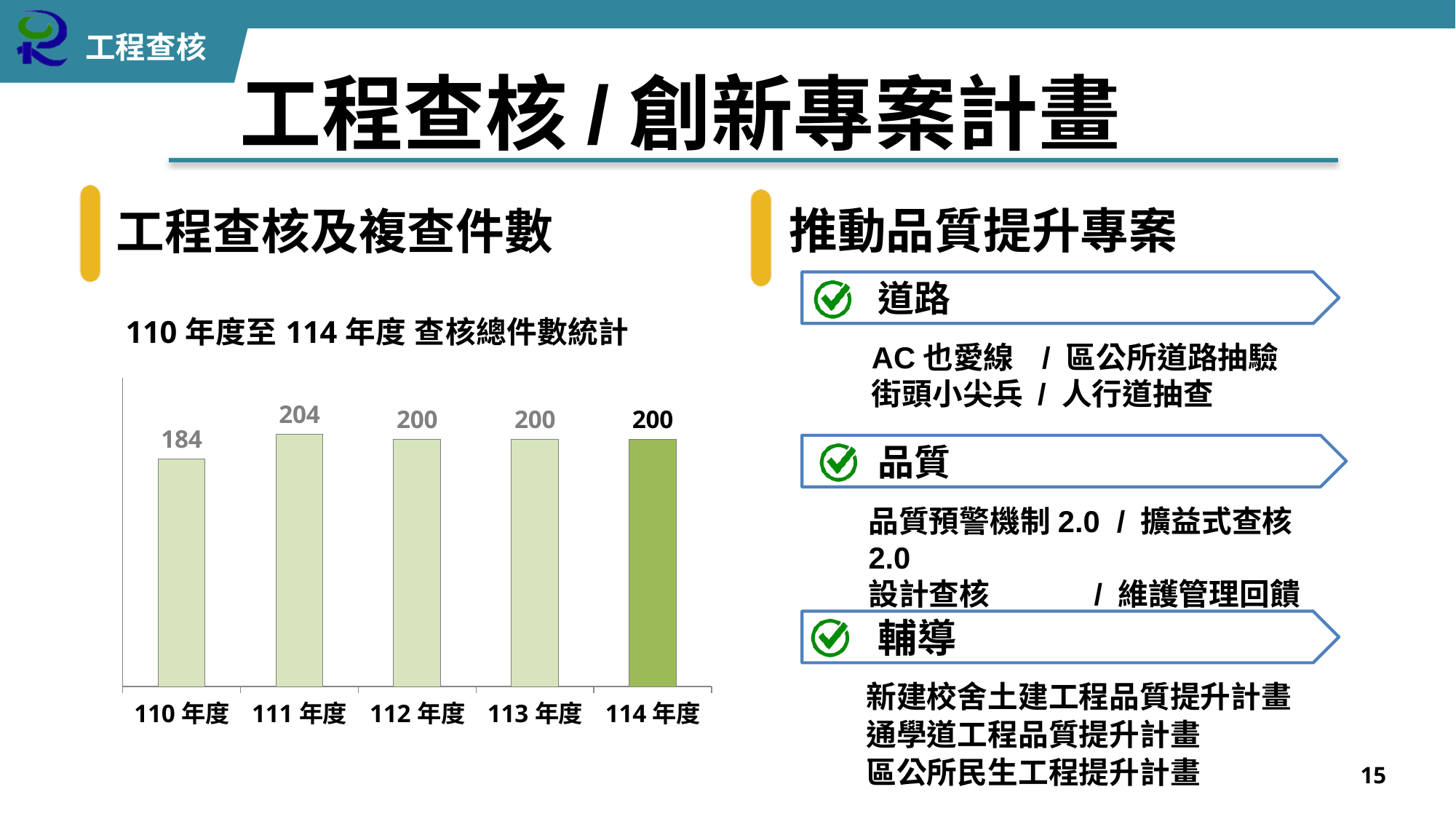
What is the title of the chart? 110 年度至 114 年度 查核總件數統計 Which year has the lowest value? 110 年度 Which is larger, the value for 110 年度 or the value for 113 年度? 113 年度 What is the value for 114 年度? 200 What is the difference between the values for 111 年度 and 112 年度? 4 Which year has the highest value? 111 年度 Which bar is shown in a darker green than the others? 114 年度 What is the value for 110 年度? 184 What is the value for 111 年度? 204 What is the difference between the values for 111 年度 and 110 年度? 20 How many years are shown on the x axis? 5 What kind of chart is this? bar chart